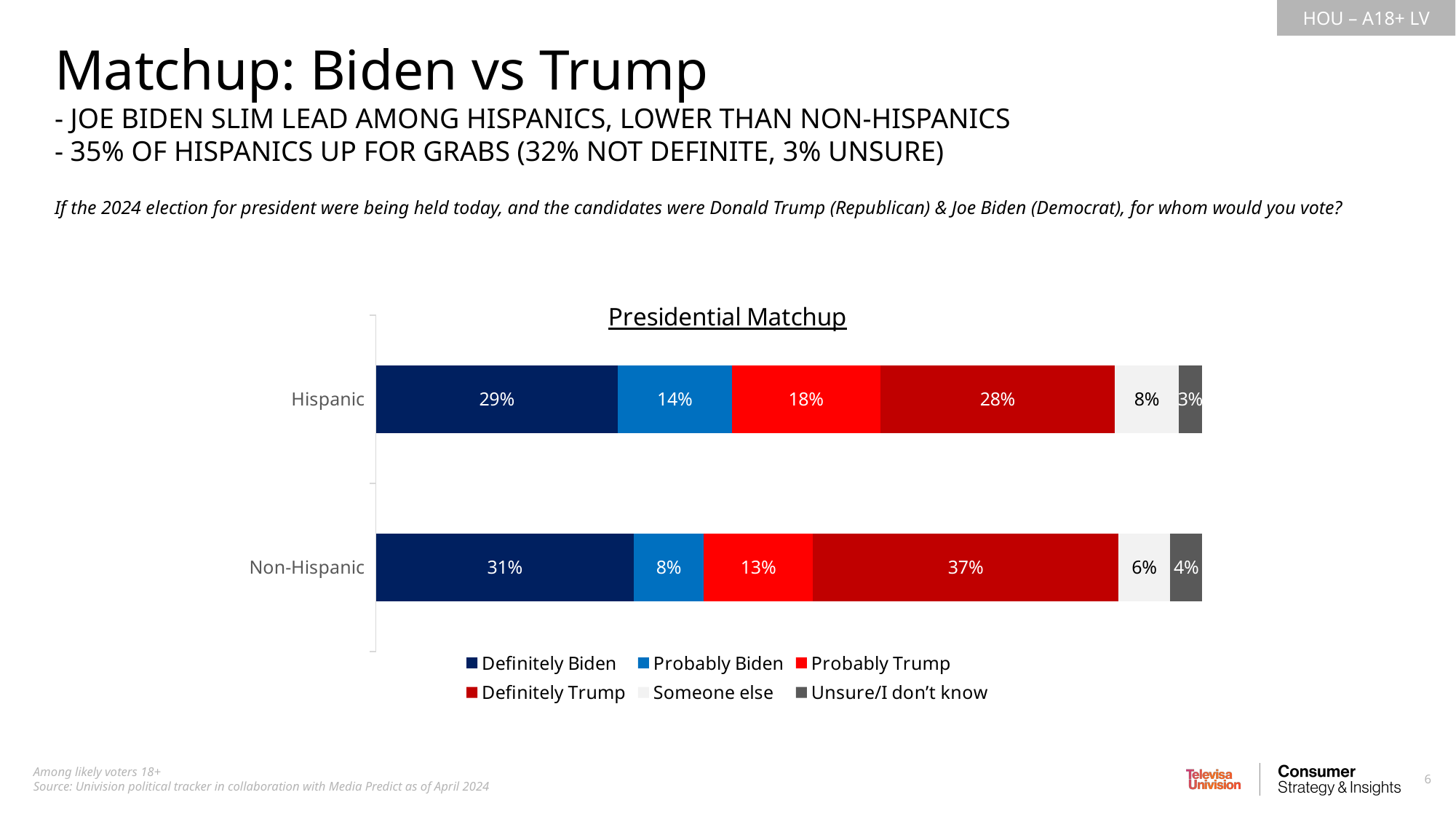
What kind of chart is shown on the slide? Stacked bar chart What is the title of the chart? Presidential Matchup Which segment is the largest in the Non-Hispanic bar? Definitely Trump What percentage of Hispanic likely voters said Definitely Biden? 29% How many series does the legend list? 6 What is the Probably Biden value for the Hispanic bar? 14% What is the Unsure/I don't know value for the Non-Hispanic bar? 4% What percentage of Non-Hispanic likely voters said Definitely Trump? 37% How many categories (groups) are shown on the chart? 2 Which group has a higher Probably Trump value, Hispanic or Non-Hispanic? Hispanic What is the difference between the Definitely Trump values for Non-Hispanic and Hispanic voters? 9 percentage points Which segment is the smallest in the Hispanic bar? Unsure/I don't know